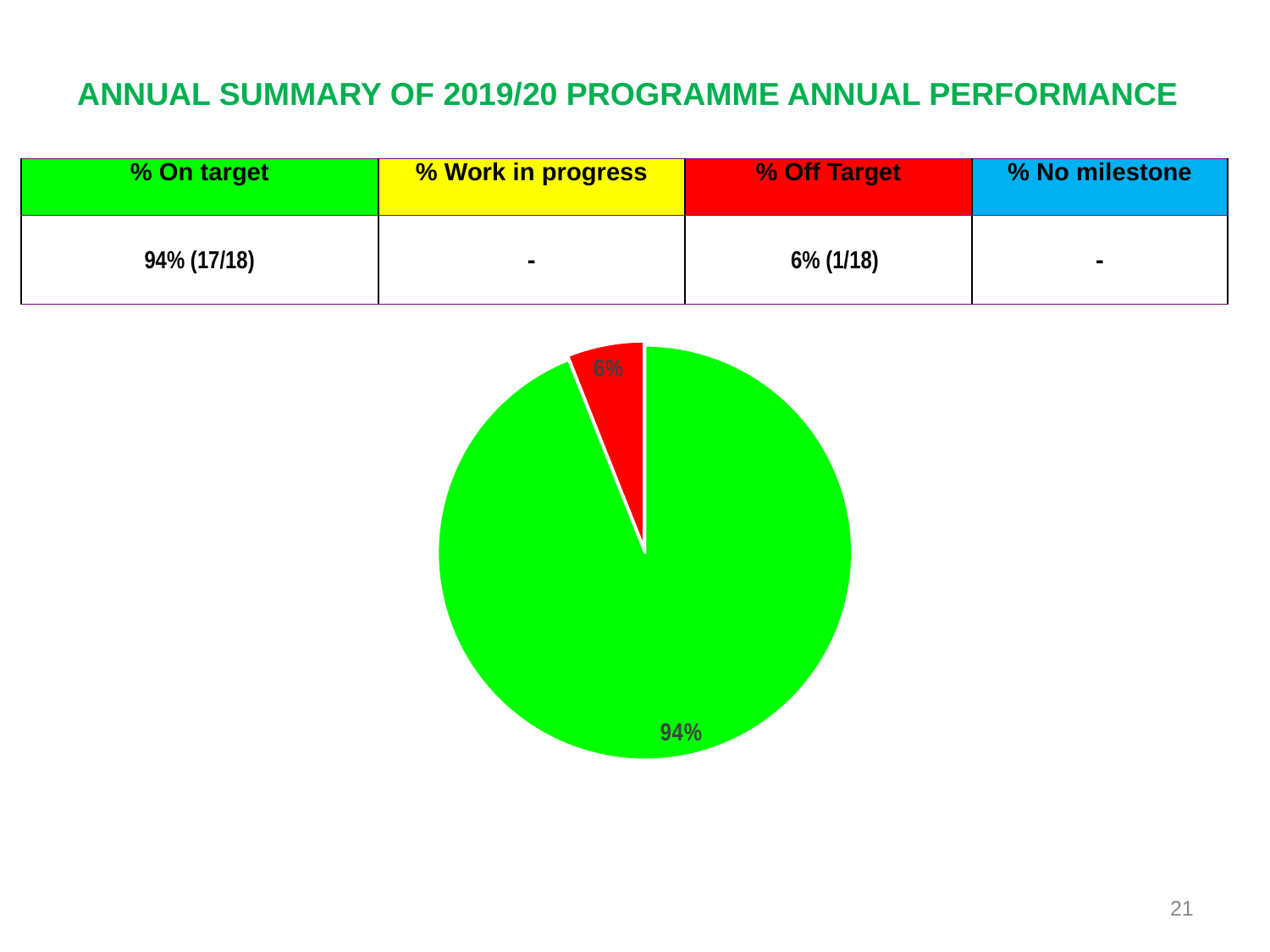
What kind of chart is shown on the slide? pie chart According to the table above the pie chart, which category does the green colour represent? % On target Which slice of the pie chart is the largest? the green slice (94%) What value is labelled on the green slice of the pie chart? 94% Which slice of the pie chart is the smallest? the red slice (6%) Which is larger in the pie chart, the green slice or the red slice? the green slice What share of the pie does the red slice represent? 6% What value is labelled on the red slice of the pie chart? 6% What is the difference between the green slice and the red slice in the pie chart? 88% According to the table above the pie chart, which category does the red colour represent? % Off Target What share of the pie does the green slice represent? 94% How many slices does the pie chart have? 2